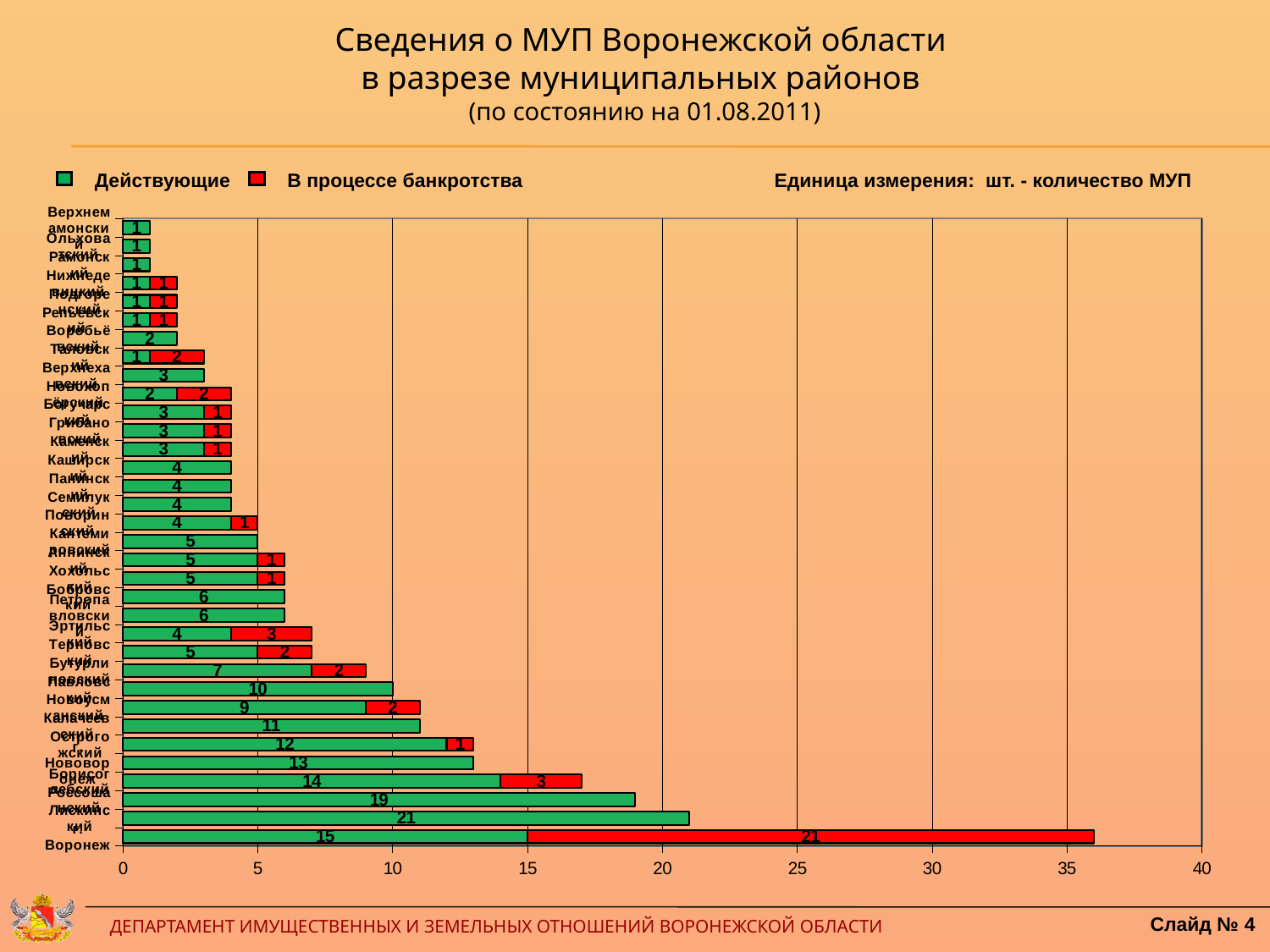
What is the value of Действующие for Воронеж? 15 What is the value of В процессе банкротства for Воронеж? 21 What unit of measurement is stated on the slide? шт. - количество МУП Which category has the highest value for В процессе банкротства? Воронеж How many series does the legend list? 2 For Воронеж, which is larger: Действующие or В процессе банкротства? В процессе банкротства For Воронеж, what is the difference between В процессе банкротства and Действующие? 6 Which colour represents Действующие in the legend? green Which category has the longest total bar? Воронеж What kind of chart is shown on the slide? bar chart Is the total bar for Воронеж greater or less than 35? greater What is the total of the stacked bar for Воронеж? 36